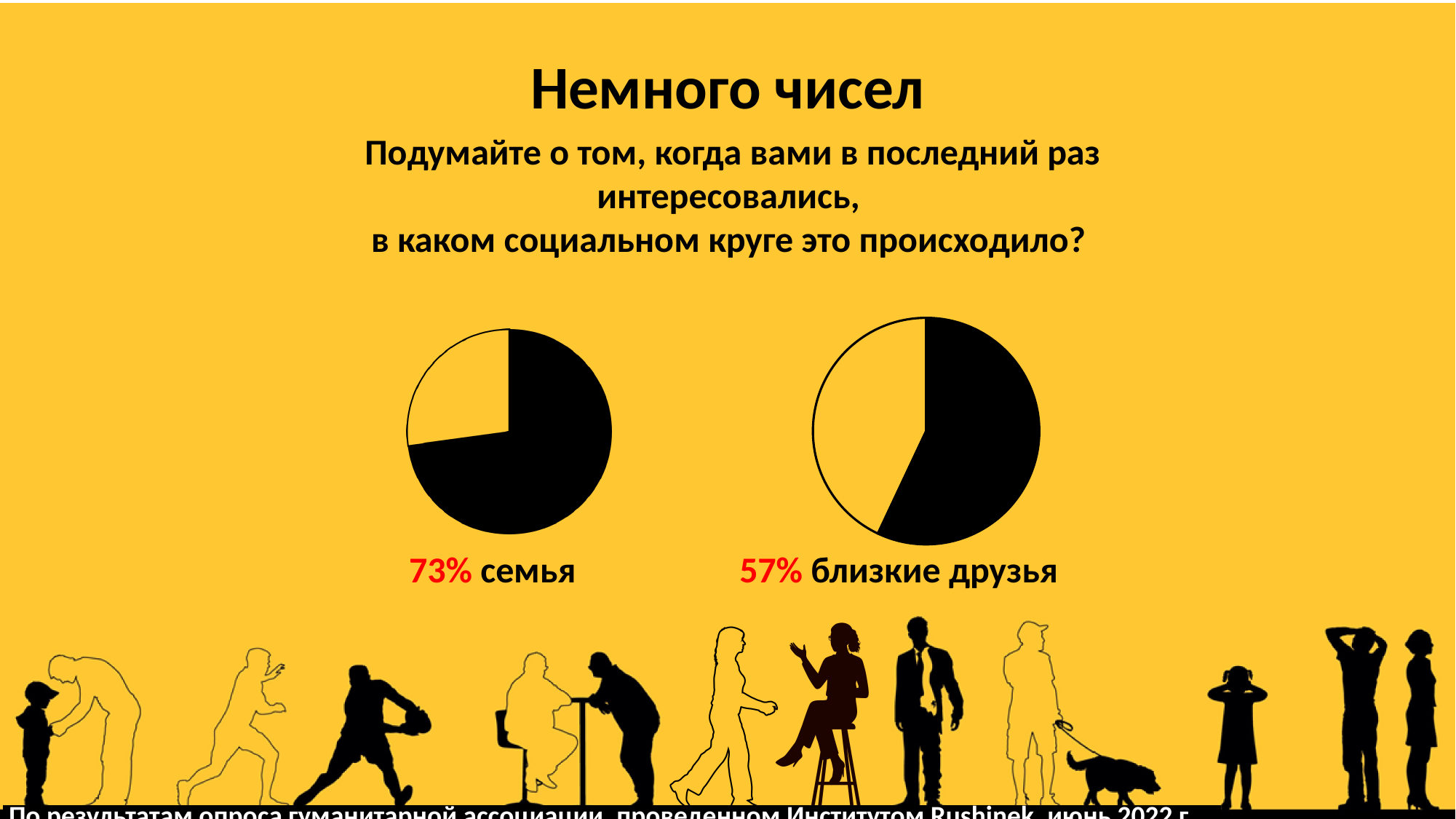
What kind of charts are shown on the slide? Pie charts In the left pie chart, is the value for семья greater or less than 50%? greater What is the difference between the percentage for семья (left chart) and близкие друзья (right chart)? 16% Which pie chart has the larger black slice, the left one (семья) or the right one (близкие друзья)? The left one (семья) In the right pie chart, what percentage is shown for близкие друзья? 57% How many slices does each pie chart have? 2 How many pie charts are on the slide? 2 Which is larger, the percentage for семья or for близкие друзья? семья In the left pie chart, what percentage is shown for семья? 73% What is the title of the slide containing the pie charts? Немного чисел What colour is the highlighted slice in both pie charts? Black In the right pie chart, is the value for близкие друзья greater or less than 50%? greater